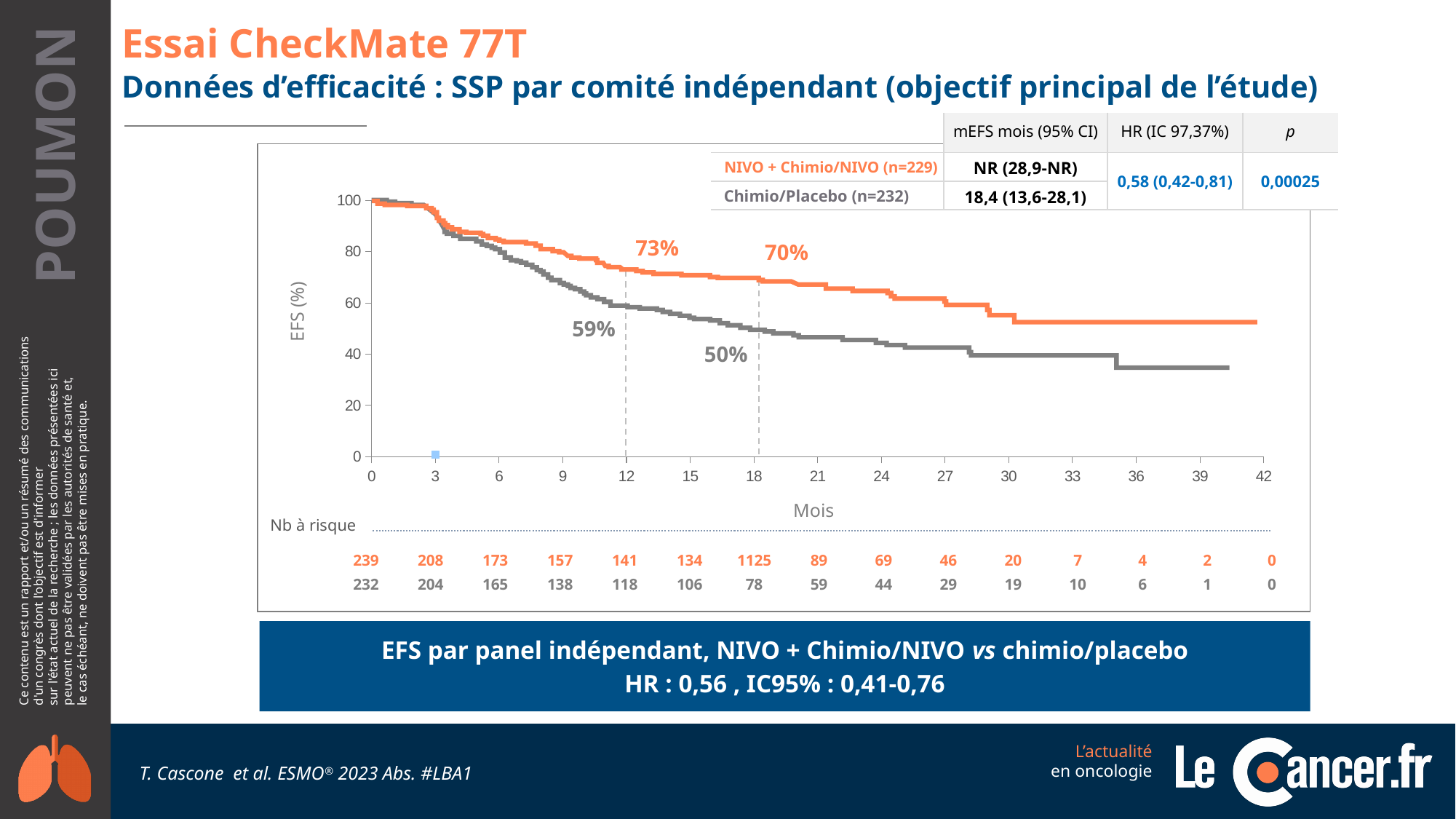
What is the EFS rate for Chimio/Placebo at 18 months? 50% What kind of chart is shown on the slide? line chart Do the EFS curves rise or fall as the months increase along the x axis? fall What is the EFS rate for Chimio/Placebo at 12 months? 59% What is the EFS rate for NIVO + Chimio/NIVO at 12 months? 73% Is the EFS value for Chimio/Placebo at 36 months greater or less than 40? less What is the label of the x axis of the chart? Mois Which arm has the higher EFS rate at 18 months? NIVO + Chimio/NIVO What is the difference in EFS rate between NIVO + Chimio/NIVO and Chimio/Placebo at 12 months? 14 percentage points How many series (treatment arms) are plotted on the chart? 2 What is the EFS rate for NIVO + Chimio/NIVO at 18 months? 70% What is the difference in EFS rate between NIVO + Chimio/NIVO and Chimio/Placebo at 18 months? 20 percentage points